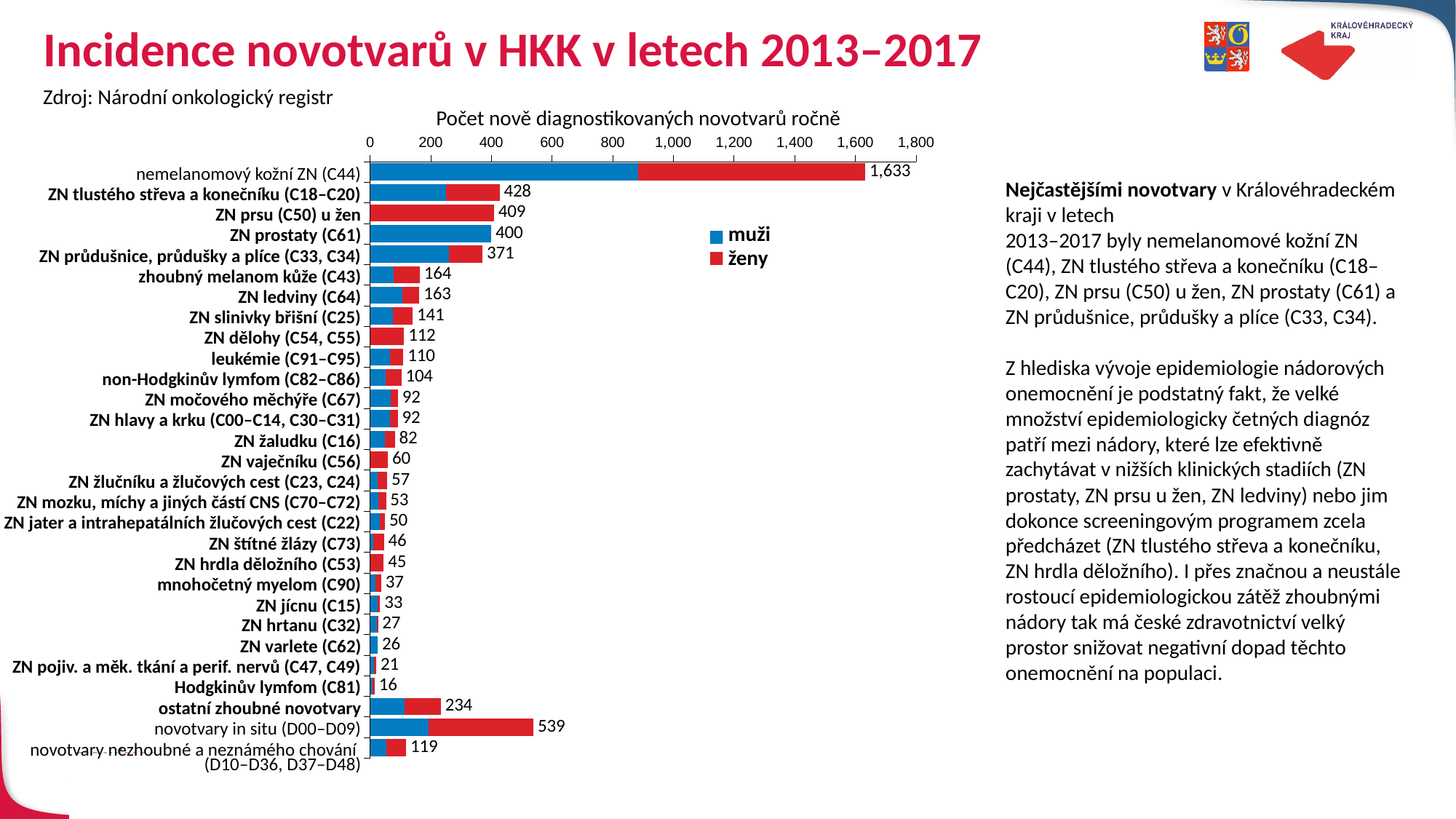
What is the total value shown for novotvary in situ (D00–D09)? 539 What kind of chart is shown on the slide? stacked bar chart What is the total number of newly diagnosed cases per year for nemelanomový kožní ZN (C44)? 1,633 What is the total value shown for ZN prostaty (C61)? 400 Which category has the highest total number of newly diagnosed cases? nemelanomový kožní ZN (C44) How many series does the legend list? 2 Which category has the lowest total number of newly diagnosed cases? Hodgkinův lymfom (C81) Which has a larger total: ZN průdušnice, průdušky a plíce (C33, C34) or ZN prostaty (C61)? ZN prostaty (C61) Is the muži value for ZN prostaty (C61) greater or less than 200? greater What is the difference between the totals for ZN tlustého střeva a konečníku (C18–C20) and ZN prsu (C50) u žen? 19 How many categories are plotted on the chart? 29 Is the ženy value for ZN prsu (C50) u žen greater or less than 200? greater